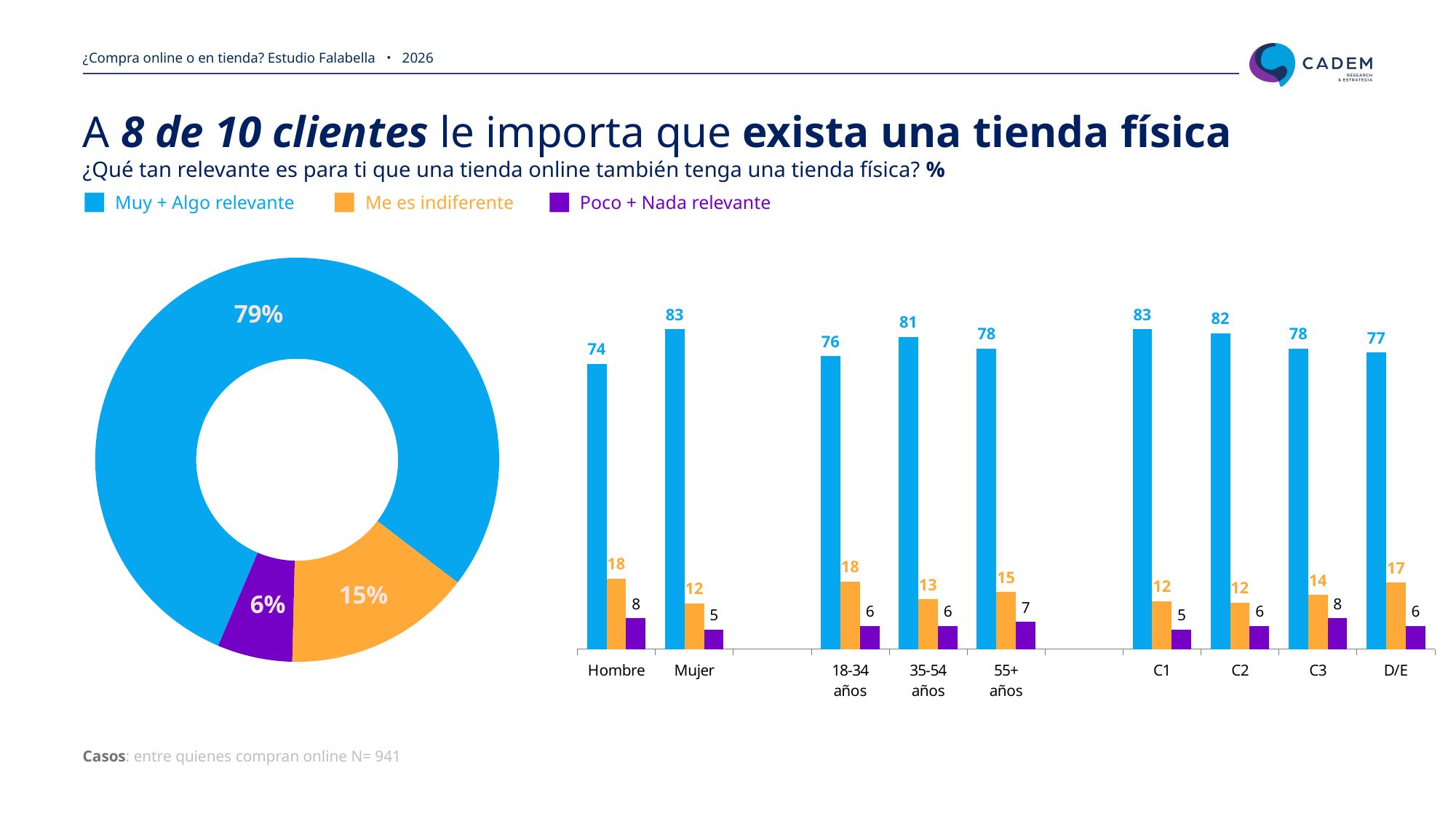
In the bar chart on the right, what is the difference between the 'Muy + Algo relevante' values for Mujer and Hombre? 9 In the bar chart on the right, what is the 'Muy + Algo relevante' value for Mujer? 83 In the donut chart on the left, what share is shown for 'Poco + Nada relevante'? 6% In the bar chart on the right, what is the 'Poco + Nada relevante' value for C3? 8 In the bar chart on the right, how many categories are shown on the x axis? 9 In the bar chart on the right, which category has the lowest 'Muy + Algo relevante' value? Hombre How many series does the legend list? 3 In the bar chart on the right, which is larger: the 'Me es indiferente' value for 18-34 años or for 35-54 años? 18-34 años In the bar chart on the right, what is the 'Me es indiferente' value for 55+ años? 15 In the donut chart on the left, which category has the smallest slice? Poco + Nada relevante What kind of chart is on the right side of the slide? Bar chart In the donut chart on the left, what share is shown for 'Muy + Algo relevante'? 79%